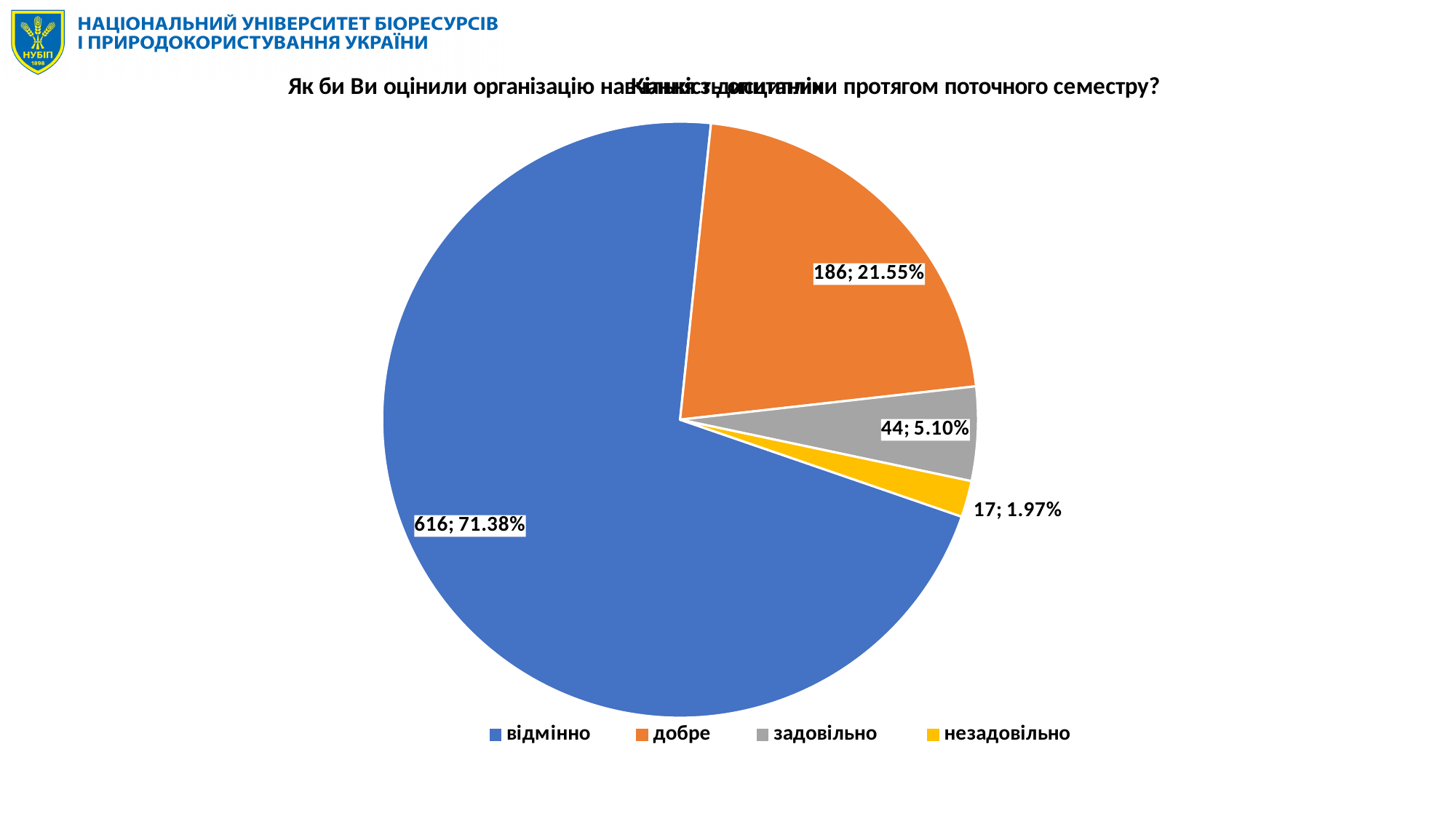
What kind of chart is shown on the slide? pie chart How many entries does the legend list? 4 What percentage is shown for the "добре" slice? 21.55% What colour is the "добре" slice? orange What percentage is shown for the "незадовільно" slice? 1.97% What is the difference between the counts for "відмінно" and "добре"? 430 Which category has the largest slice? відмінно Which category has the smallest slice? незадовільно What is the count shown for the "відмінно" slice? 616 How many slices does the pie chart have? 4 What is the count shown for the "задовільно" slice? 44 Which is larger, the count for "задовільно" or for "незадовільно"? задовільно